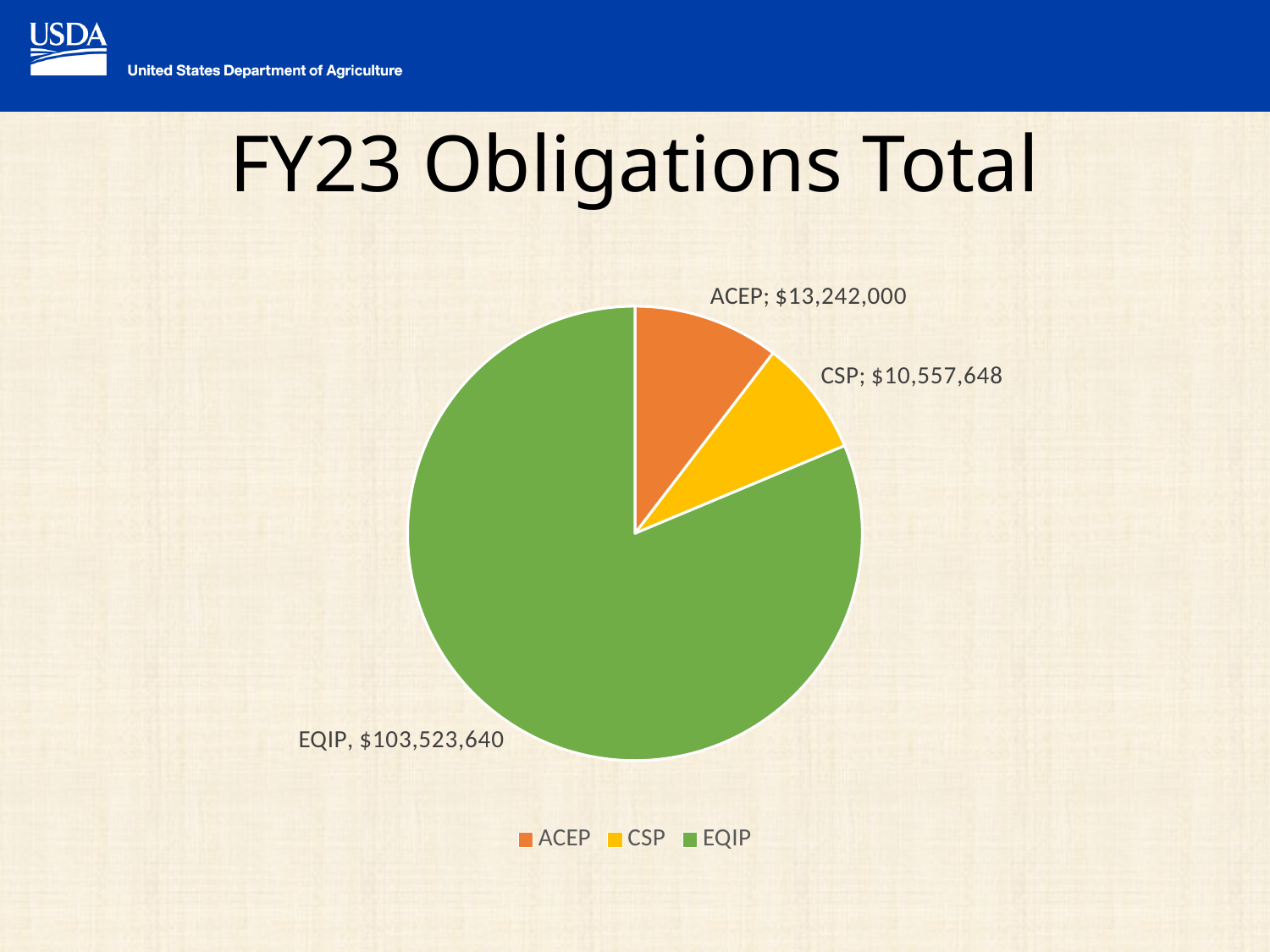
Which is larger, the value for ACEP or the value for CSP? ACEP How many entries does the legend list? 3 How many slices does the pie chart have? 3 Which program has the largest slice of the pie chart? EQIP What is the value for CSP in the FY23 Obligations Total pie chart? $10,557,648 Which program has the smallest slice of the pie chart? CSP What is the difference between the ACEP value and the CSP value? $2,684,352 What is the value for EQIP in the FY23 Obligations Total pie chart? $103,523,640 What is the difference between the EQIP value and the ACEP value? $90,281,640 What type of chart is shown on the slide? Pie chart What is the value for ACEP in the FY23 Obligations Total pie chart? $13,242,000 What is the title of the chart on the slide? FY23 Obligations Total